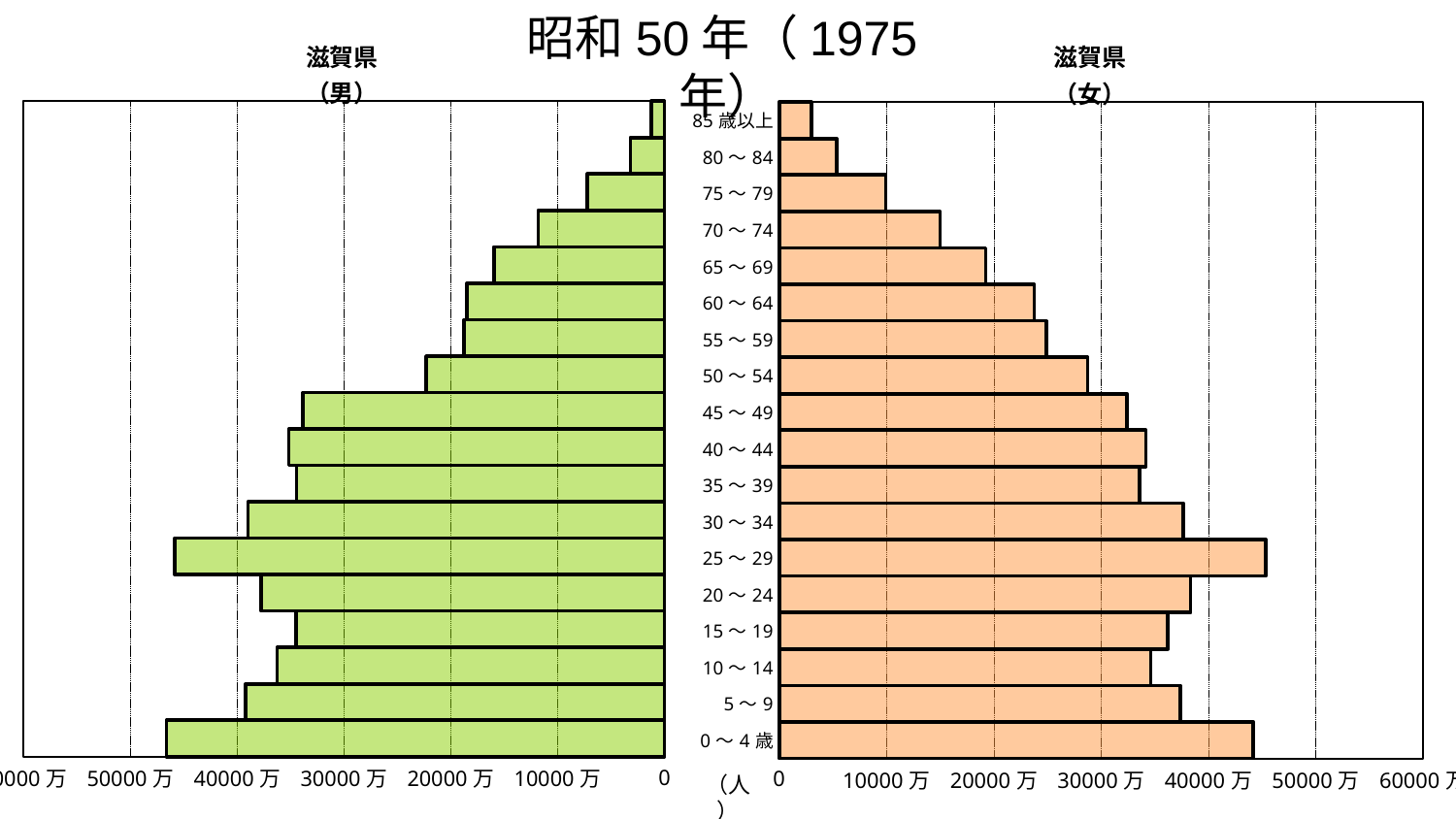
In the 滋賀県（男） chart, which age group has the smallest value? 85歳以上 In the 滋賀県（女） chart, which age group has the smallest value? 85歳以上 What is the main title of the slide above the two charts? 昭和50年（1975年） In the 滋賀県（男） chart, which is larger, the value for 25～29 or the value for 20～24? 25～29 How many age groups are plotted in the 滋賀県（男） chart? 18 In the 滋賀県（男） chart, is the value for 45～49 greater or less than 30000万? greater In the 滋賀県（女） chart, is the value for 70～74 greater or less than 20000万? less In the 滋賀県（女） chart, which is larger, the value for 25～29 or the value for 30～34? 25～29 In the 滋賀県（女） chart, is the value for 0～4歳 greater or less than 40000万? greater What kind of chart is shown on the left side of the slide (滋賀県（男）)? bar chart